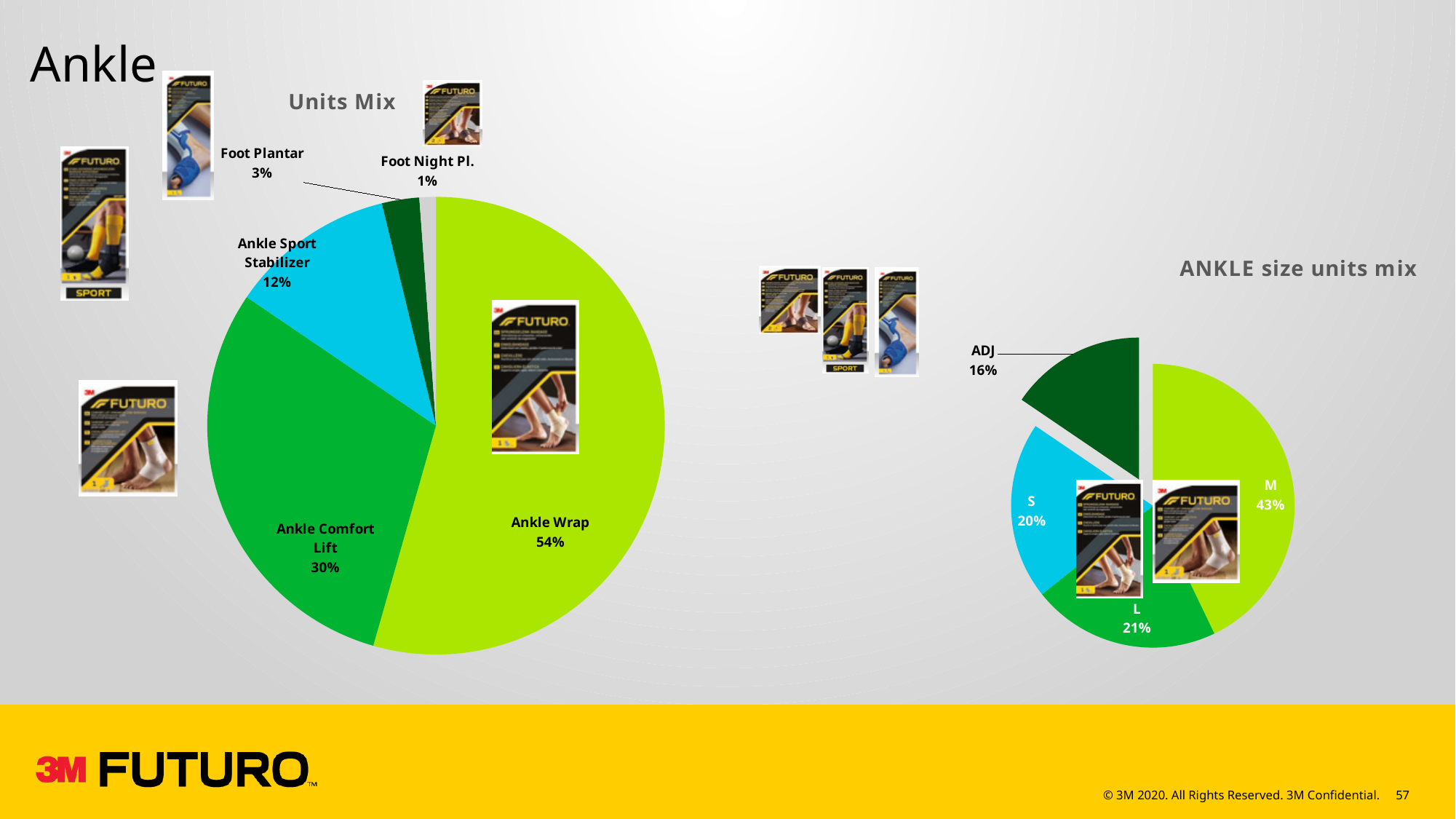
What kind of chart is the ANKLE size units mix chart? Pie chart In the Units Mix chart, what share does Ankle Sport Stabilizer have? 12% In the ANKLE size units mix chart, what share does size M have? 43% In the Units Mix chart, what share does Ankle Comfort Lift have? 30% In the Units Mix chart, how many categories are shown? 5 In the ANKLE size units mix chart, which slice is pulled out from the pie? ADJ In the ANKLE size units mix chart, which is larger, S or L? L In the ANKLE size units mix chart, what share does ADJ have? 16% In the Units Mix chart, which category has the smallest share? Foot Night Pl. In the Units Mix chart, what share does Ankle Wrap have? 54% In the Units Mix chart, what is the difference between the Ankle Wrap and Ankle Comfort Lift shares? 24% In the Units Mix chart, which category has the largest share? Ankle Wrap